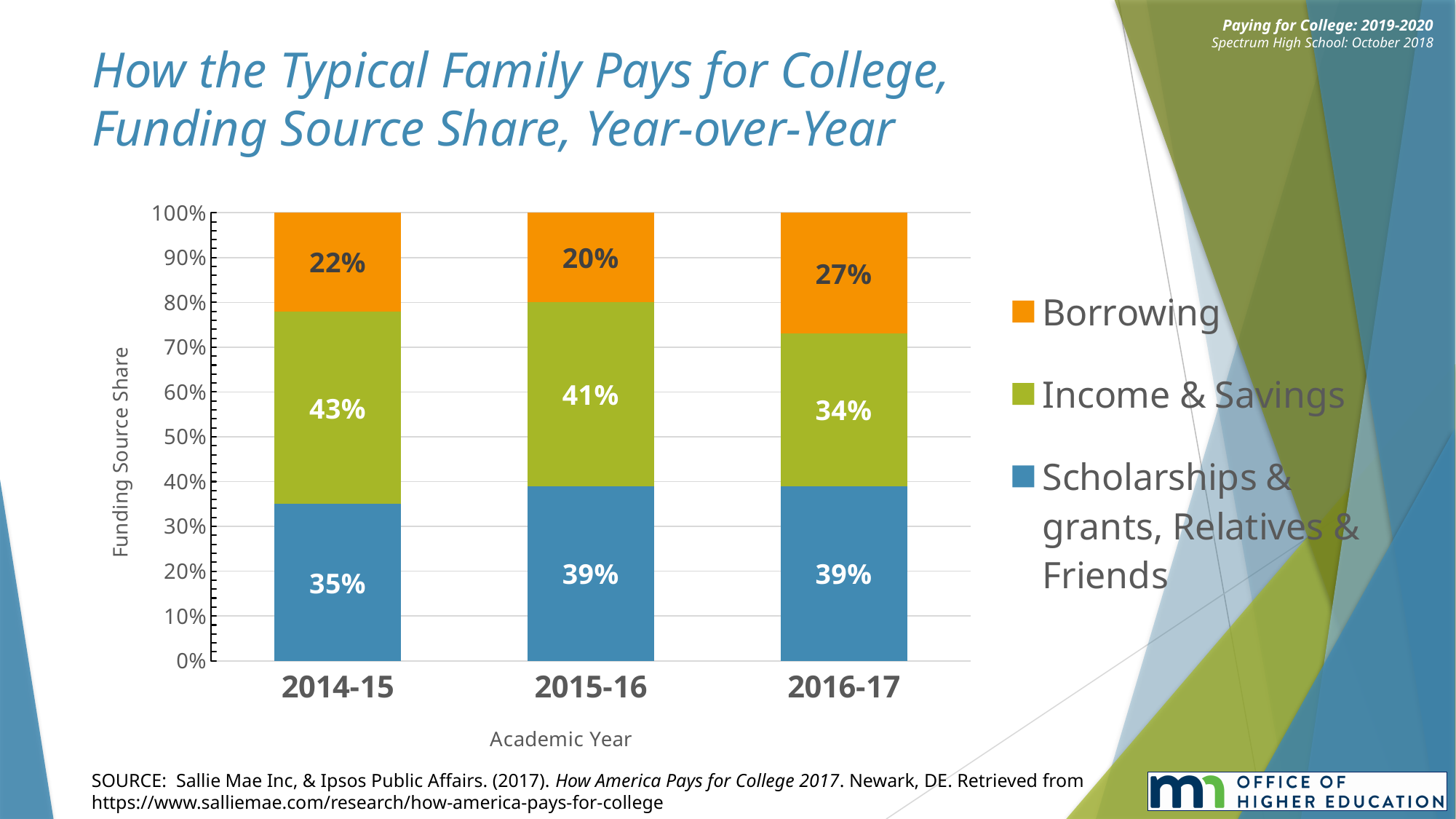
What is the Income & Savings share for 2014-15? 43% Is the Borrowing share larger in 2015-16 or in 2016-17? 2016-17 What is the Scholarships & grants, Relatives & Friends share for 2015-16? 39% Which academic year has the lowest Income & Savings share? 2016-17 What is the Borrowing share for 2016-17? 27% Does the Income & Savings share rise or fall from 2014-15 to 2016-17? Fall What colour represents Borrowing in the chart? Orange Which academic year has the highest Borrowing share? 2016-17 What kind of chart is shown on the slide? Stacked bar chart What is the difference between the Income & Savings share in 2014-15 and in 2016-17? 9% How many series does the legend list? 3 How many academic years are shown on the x axis? 3